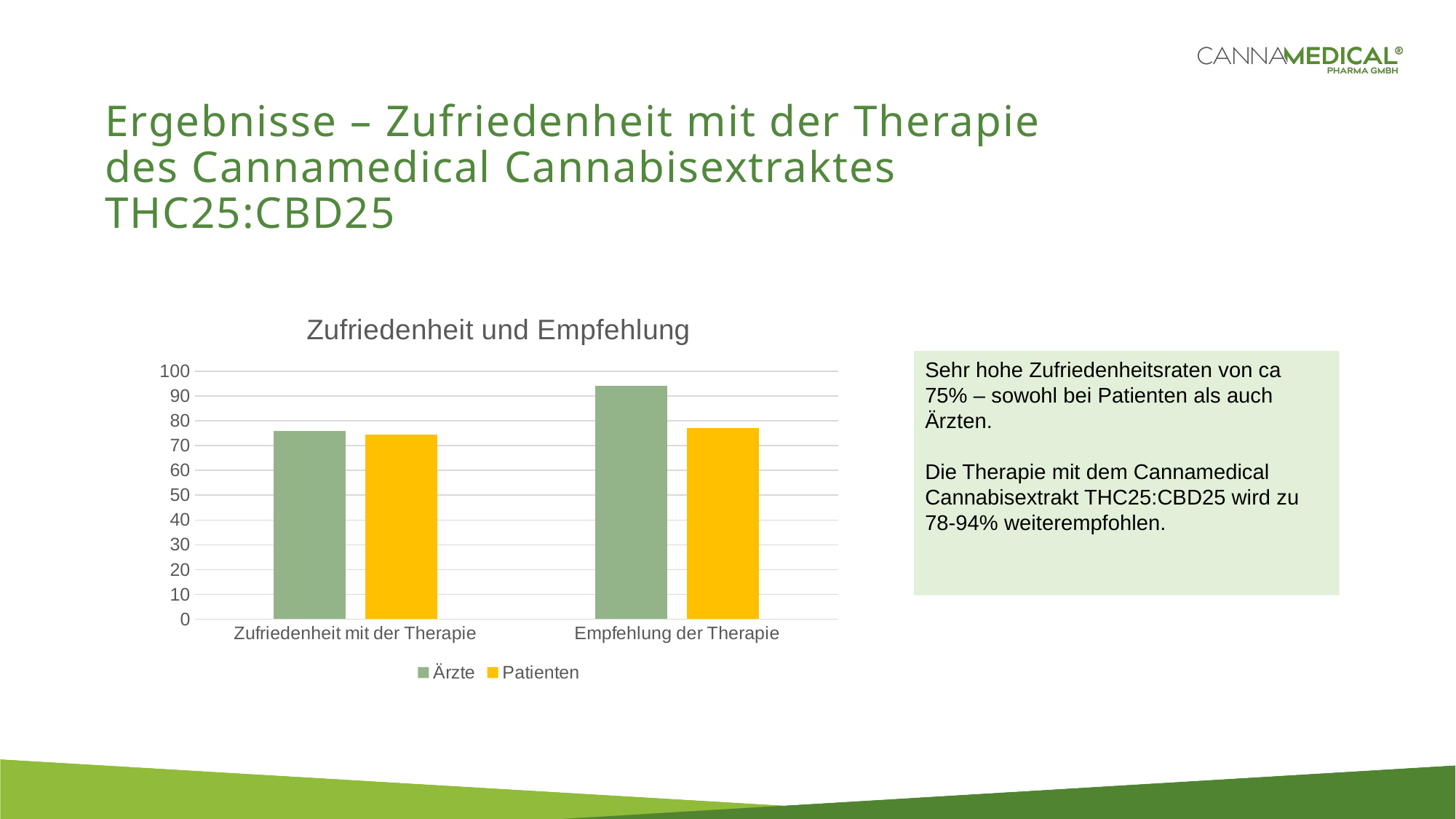
Is the value for Ärzte in "Zufriedenheit mit der Therapie" greater or less than 80? less What kind of chart is shown under the title "Zufriedenheit und Empfehlung"? bar chart Is the value for Patienten in "Zufriedenheit mit der Therapie" greater or less than 70? greater Is the value for Patienten in "Empfehlung der Therapie" greater or less than 70? greater Which series are listed in the chart's legend? Ärzte, Patienten How many categories are shown on the x axis of the chart? 2 How many series does the legend of the chart list? 2 For "Empfehlung der Therapie", which is larger: the value for Ärzte or for Patienten? Ärzte Which bar is the highest in the chart? Ärzte, Empfehlung der Therapie What is the title of the chart? Zufriedenheit und Empfehlung